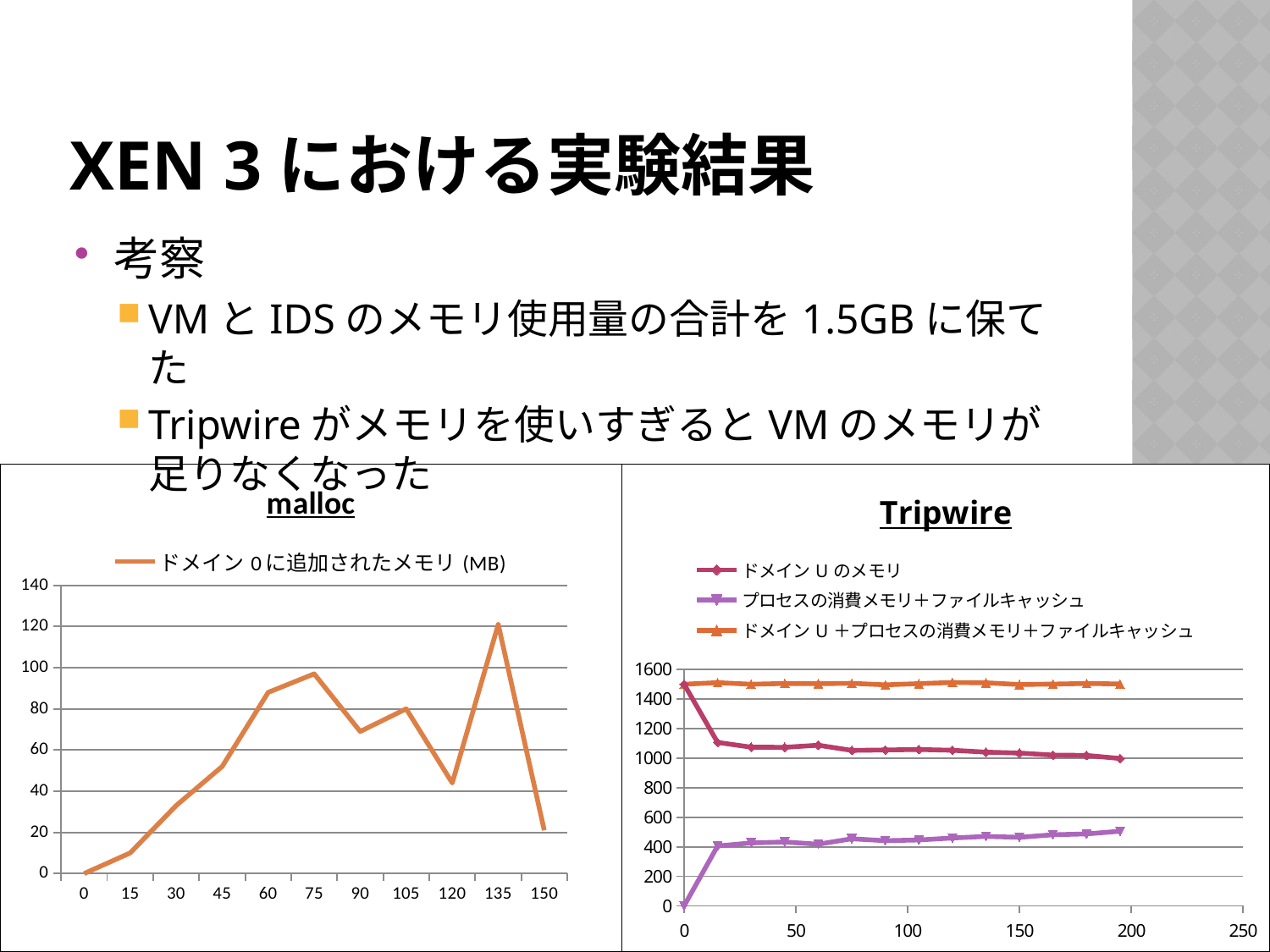
How many x-axis categories are plotted in the malloc chart? 11 What kind of chart is the malloc chart? line chart In the malloc chart, at which x value is the added memory lowest? 0 What is the legend entry of the single series in the malloc chart? ドメイン 0 に追加されたメモリ (MB) In the Tripwire chart, which series has the highest values? ドメイン U ＋プロセスの消費メモリ＋ファイルキャッシュ How many series does the legend of the Tripwire chart list? 3 In the malloc chart, at which x value is the added memory highest? 135 In the malloc chart, is the value at x = 135 greater or less than 100? greater In the malloc chart, which is larger: the value at x = 75 or the value at x = 120? x = 75 In the Tripwire chart, does the ドメイン U のメモリ series rise or fall along the x axis? fall In the malloc chart, is the value at x = 150 greater or less than 40? less